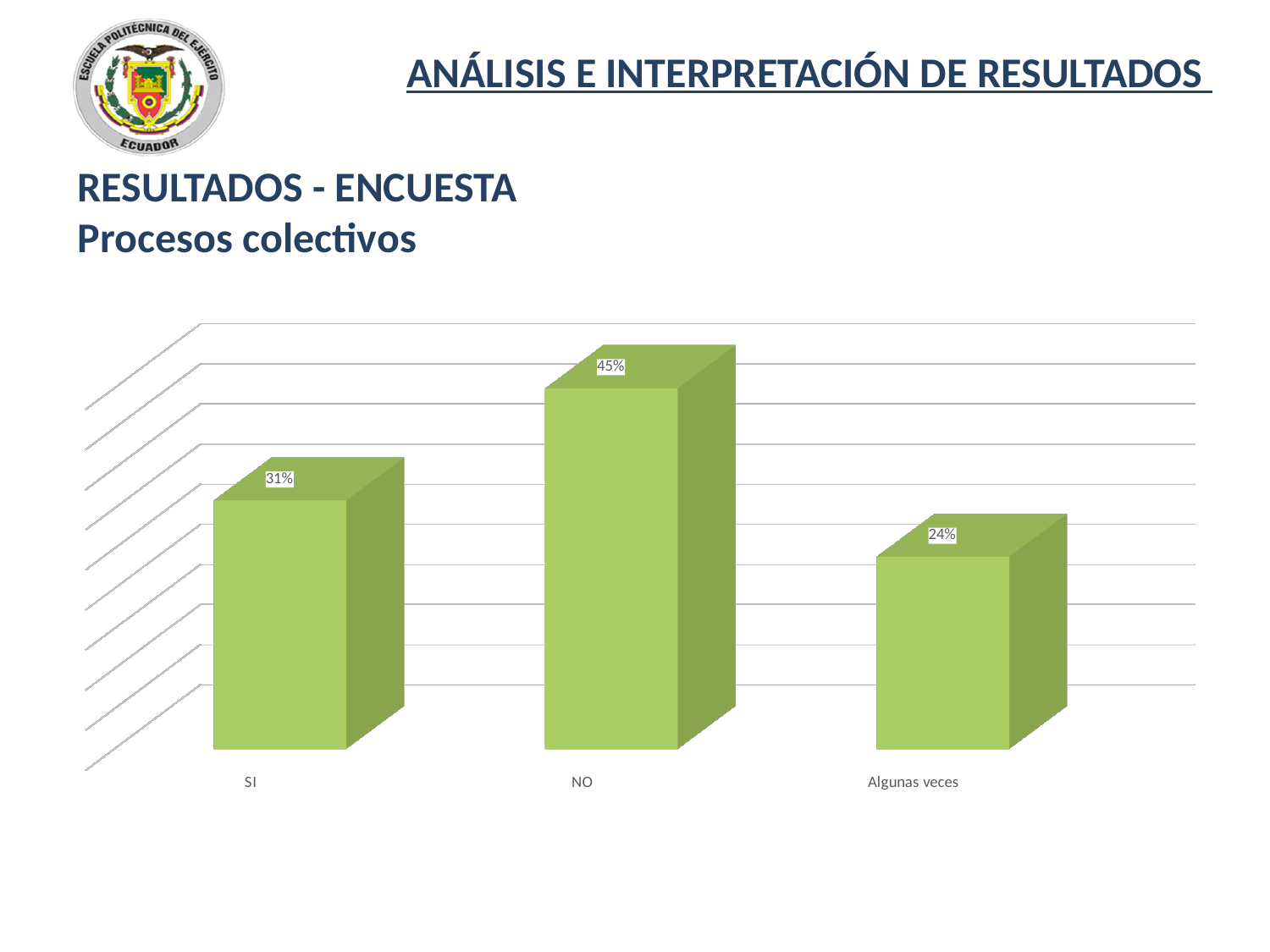
What kind of chart is shown on the slide? bar chart What is the difference between the values for NO and SI? 14% What is the total of the three values shown? 100% What is the value for SI? 31% Which is larger, the value for SI or the value for Algunas veces? SI How many categories are shown on the x axis? 3 What colour are the bars in the chart? green Which category has the highest value? NO What is the difference between the values for SI and Algunas veces? 7% Which category has the lowest value? Algunas veces What is the value for Algunas veces? 24% What is the value for NO? 45%